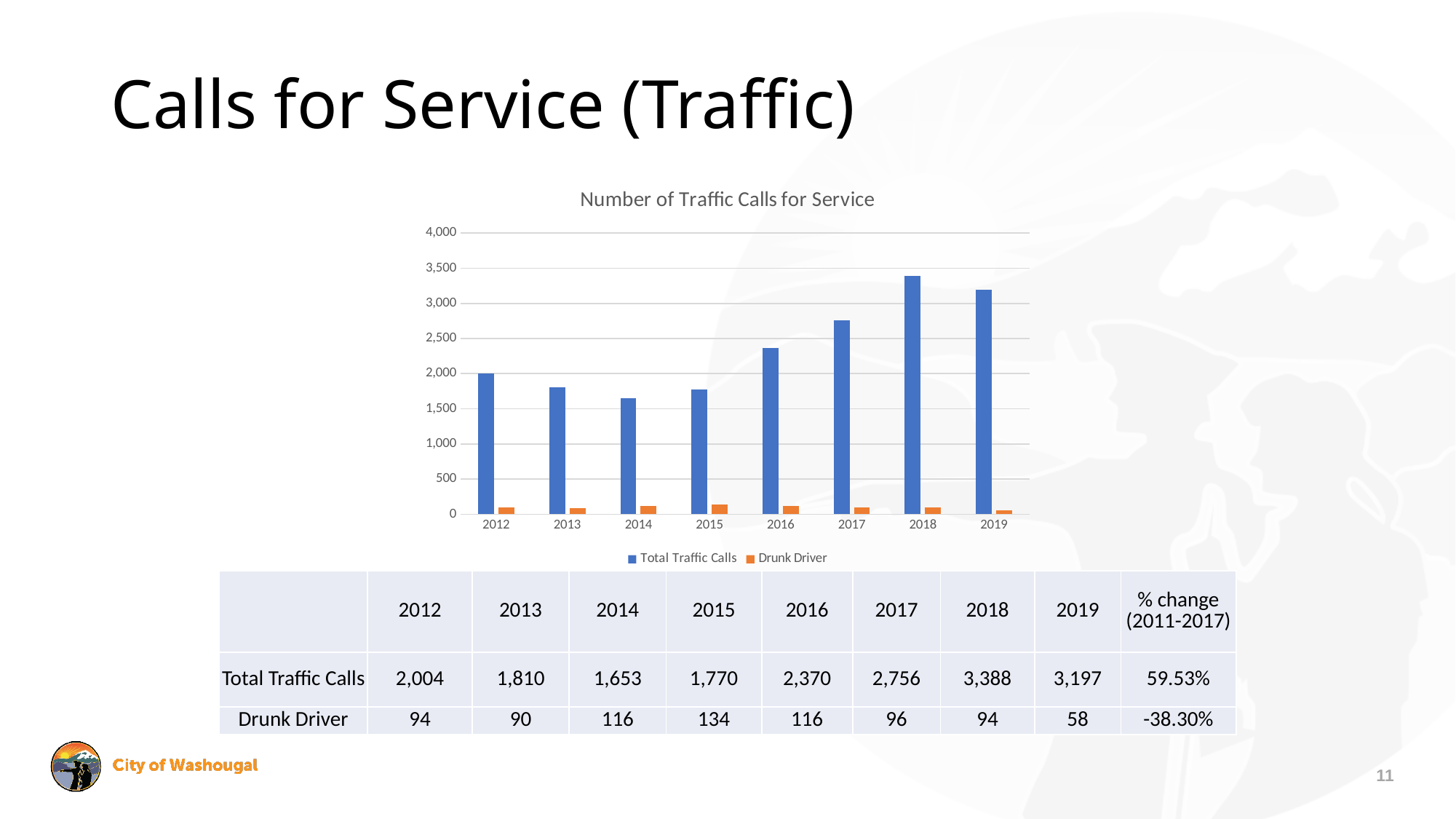
Which year has the highest number of Total Traffic Calls? 2018 Which is larger, Total Traffic Calls in 2012 or in 2013? 2012 What kind of chart is shown on the slide? bar chart Which year has the lowest number of Total Traffic Calls? 2014 What is the value of Drunk Driver calls for 2015? 134 What is the title of the chart? Number of Traffic Calls for Service How many series does the chart legend list? 2 What is the difference in Total Traffic Calls between 2018 and 2019? 191 Which year has the lowest number of Drunk Driver calls? 2019 Is the value for Total Traffic Calls in 2017 greater or less than 2,500? greater How many years are shown on the x axis of the chart? 8 What is the value of Total Traffic Calls for 2018? 3,388